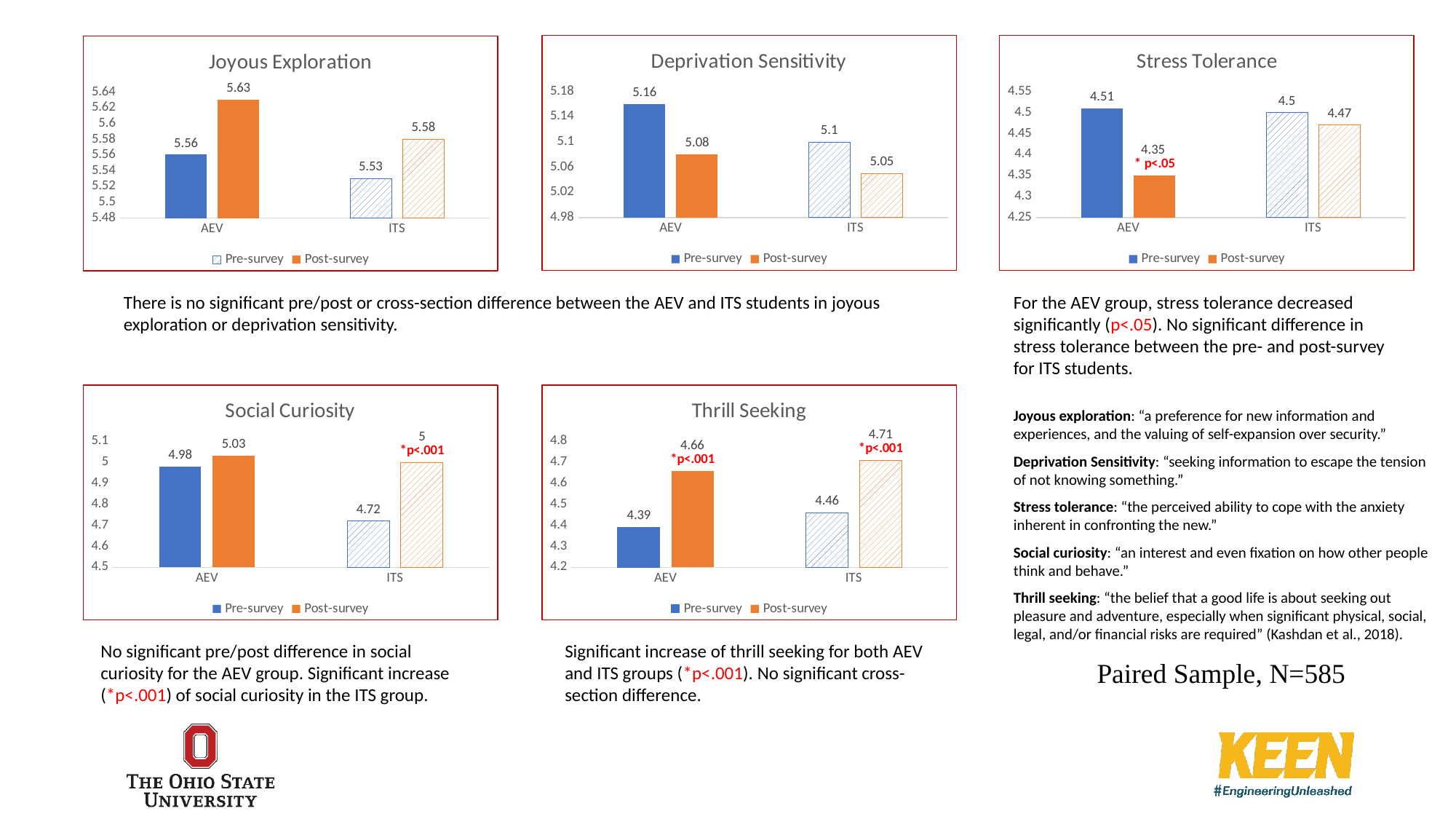
How many series does the legend of the Joyous Exploration chart list? 2 In the Stress Tolerance chart, which group and survey has the lowest value? AEV Post-survey In the Stress Tolerance chart, what is the Post-survey value for AEV? 4.35 In the Thrill Seeking chart, which group and survey has the highest value? ITS Post-survey In the Deprivation Sensitivity chart, what is the Pre-survey value for ITS? 5.1 In the Joyous Exploration chart, what is the Post-survey value for AEV? 5.63 In the Thrill Seeking chart, what is the difference between the Post-survey and Pre-survey values for AEV? 0.27 What type of chart is the Thrill Seeking chart? Bar chart In the Social Curiosity chart, what is the difference between the Post-survey and Pre-survey values for ITS? 0.28 In the Social Curiosity chart, what is the Post-survey value for ITS? 5 In the Deprivation Sensitivity chart, which is larger for AEV: the Pre-survey or Post-survey value? Pre-survey How many charts are shown on the slide? 5